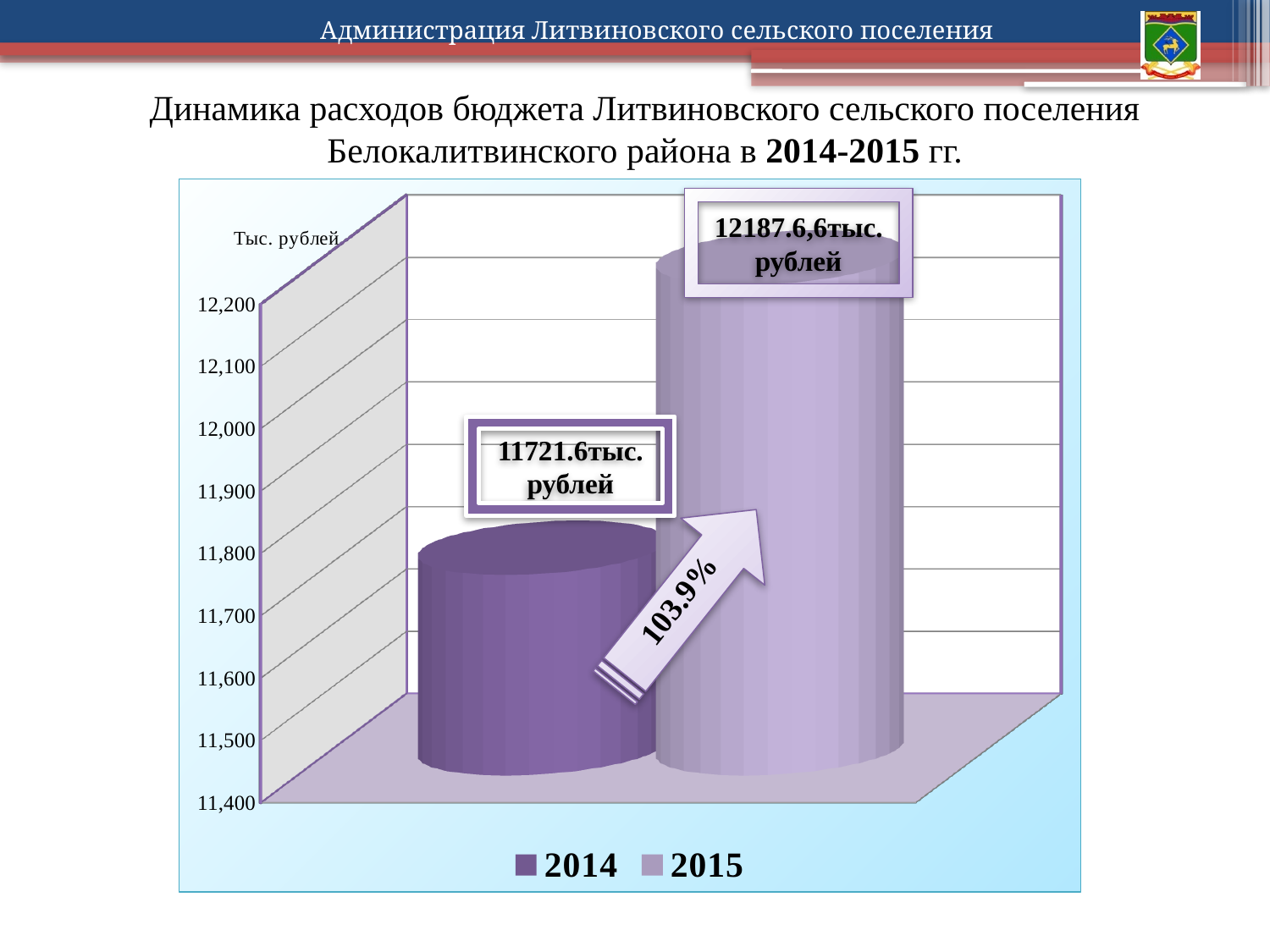
What value is labelled on the bar for 2014? 11721.6тыс. рублей Which year has the lowest budget expenditure in the chart? 2014 How many bars are plotted in the chart? 2 Is the value for 2015 greater or less than 12,000? greater What kind of chart is shown on the slide? bar chart Is the value for 2014 greater or less than 11,900? less Which year has the highest budget expenditure in the chart? 2015 What percentage is written on the arrow between the two bars? 103.9% What value is labelled on the bar for 2015? 12187.6,6тыс. рублей How many series does the legend list? 2 Do the values rise or fall from 2014 to 2015? rise Which is larger, the value for 2014 or the value for 2015? 2015